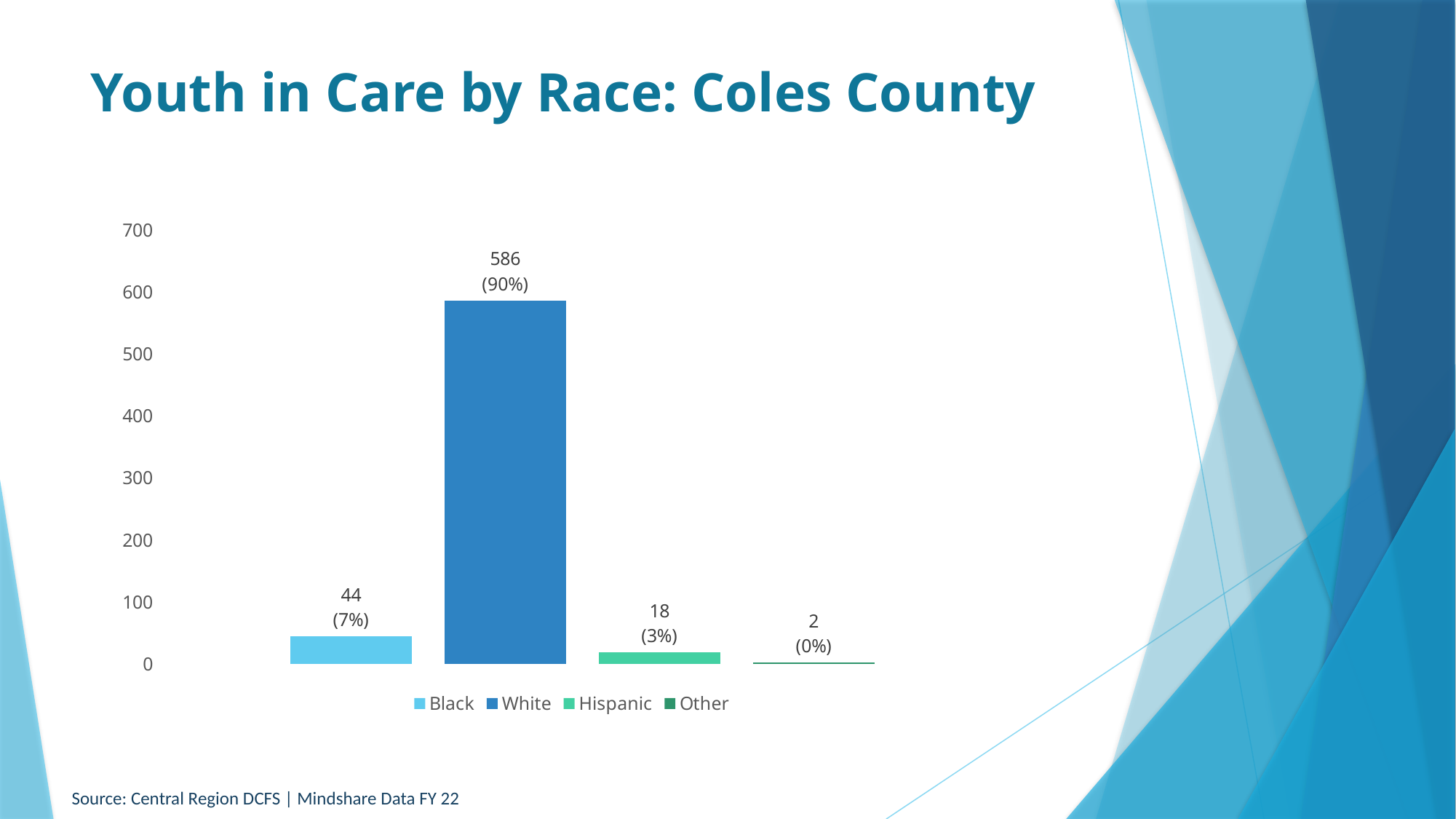
What is the difference between the Black and Hispanic values? 26 What is the difference between the White and Black values? 542 How many race categories are shown in the chart? 4 What percentage is shown for the Other category? 0% What is the number of youth in care for Black? 44 What is the number of youth in care for Hispanic? 18 Which race category has the highest number of youth in care? White What kind of chart is shown on the slide? Bar chart Which race category has the lowest number of youth in care? Other What is the number of youth in care for White? 586 Which is larger, the value for Black or the value for Hispanic? Black Is the value for White greater or less than 500? greater